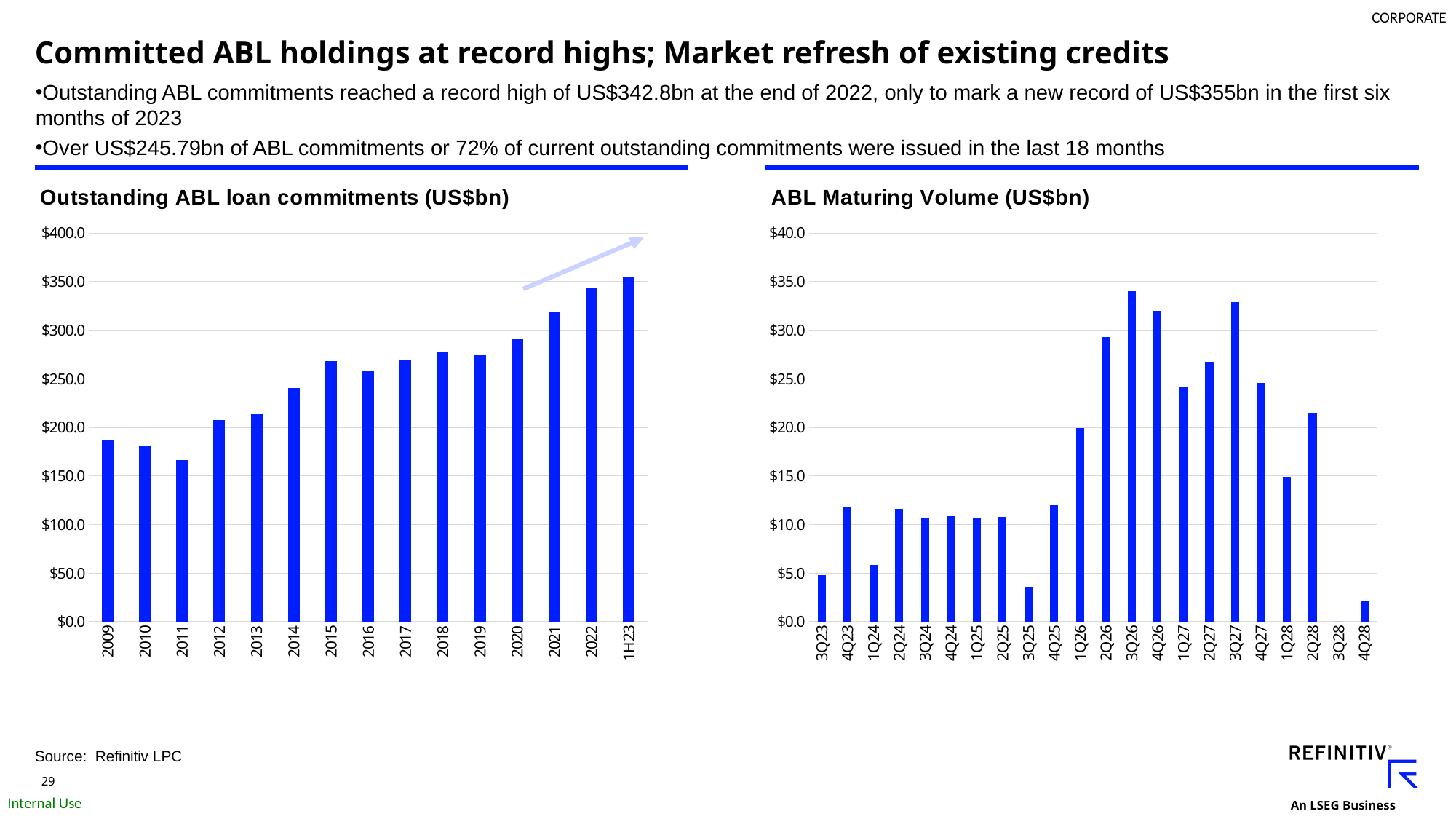
What is the title of the chart on the right side of the slide? ABL Maturing Volume (US$bn) In the 'Outstanding ABL loan commitments (US$bn)' chart, is the value for 2020 greater or less than $250.0? greater What kind of chart is the 'Outstanding ABL loan commitments (US$bn)' chart? bar chart In the 'ABL Maturing Volume (US$bn)' chart, is the value for 3Q25 greater or less than $5.0? less In the 'ABL Maturing Volume (US$bn)' chart, which is larger, the value for 1Q26 or the value for 2Q26? 2Q26 In the 'Outstanding ABL loan commitments (US$bn)' chart, is the value for 2009 greater or less than $200.0? less In the 'Outstanding ABL loan commitments (US$bn)' chart, which is larger, the value for 2013 or the value for 2014? 2014 In the 'Outstanding ABL loan commitments (US$bn)' chart, which year has the lowest value? 2011 In the 'Outstanding ABL loan commitments (US$bn)' chart, which period has the highest value? 1H23 How many periods are shown on the x axis of the 'Outstanding ABL loan commitments (US$bn)' chart? 15 How many quarters are listed on the x axis of the 'ABL Maturing Volume (US$bn)' chart? 22 In the 'Outstanding ABL loan commitments (US$bn)' chart, do the values generally rise or fall from 2011 to 1H23? rise